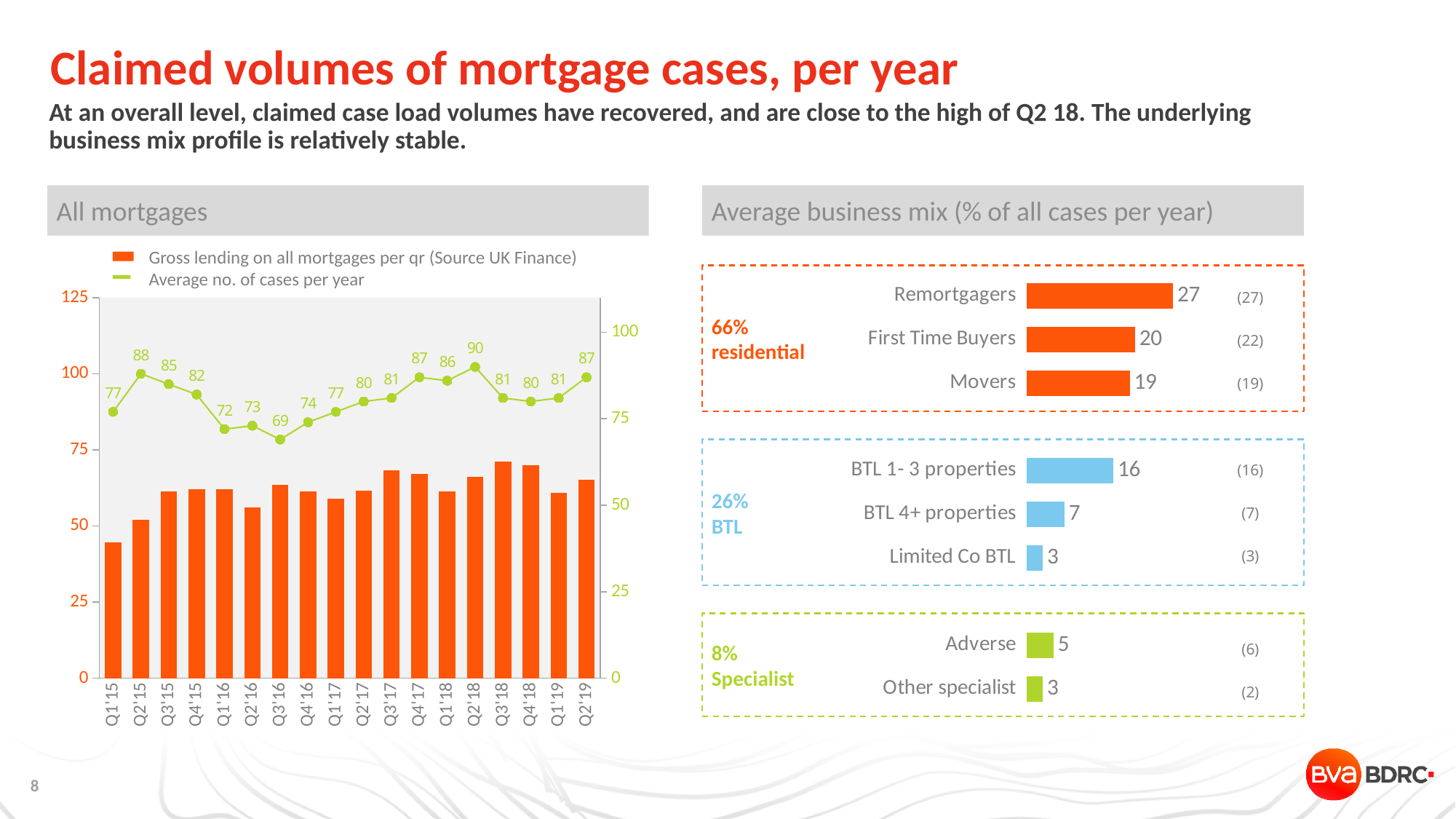
In the 'All mortgages' chart, what is the difference between the average number of cases per year in Q2'18 and Q3'16? 21 In the 'All mortgages' chart, which quarter has the highest average number of cases per year? Q2'18 In the 'All mortgages' chart, what is the average number of cases per year for Q3'16? 69 In the 'Average business mix' chart, what is the value for Remortgagers? 27 In the 'All mortgages' chart, how many quarters are shown on the x axis? 18 In the 'All mortgages' chart, what is the average number of cases per year for Q2'18? 90 In the 'Average business mix' chart, which is larger: BTL 1- 3 properties or BTL 4+ properties? BTL 1- 3 properties In the 'All mortgages' chart, how many series does the legend list? 2 In the 'All mortgages' chart, which quarter has the lowest average number of cases per year? Q3'16 What kind of chart is the 'Average business mix' chart? Bar chart In the 'Average business mix' chart, which category has the highest value? Remortgagers In the 'All mortgages' chart, is the gross lending bar for Q1'15 greater or less than 50? less